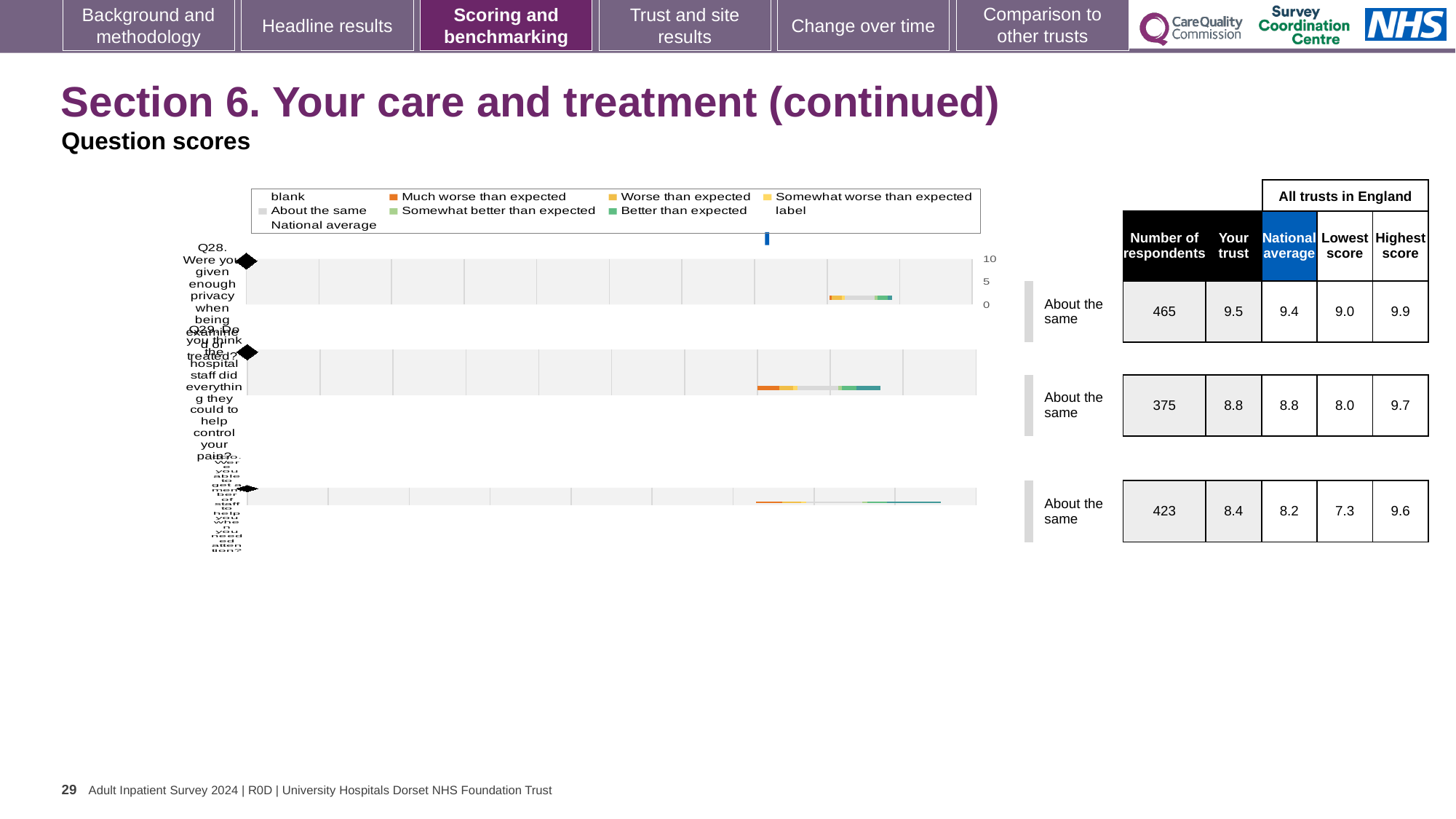
How many respondents are listed for the third question (Q30)? 423 What is the lowest score among all trusts in England for the third question (Q30)? 7.3 What is the highest score among all trusts in England for Q28? 9.9 For Q29 (Do you think the hospital staff did everything they could to help control your pain?), what is the national average score? 8.8 What is the difference between the highest and lowest scores among all trusts in England for the third question (Q30)? 2.3 Which question has the highest 'Your trust' score on this slide? Q28 For Q28 (Were you given enough privacy when being examined or treated?), what is the 'Your trust' score shown? 9.5 What benchmark category is shown for Q29? About the same How many questions are plotted on this slide? 3 What is the difference between the 'Your trust' score and the national average for Q28? 0.1 What kind of chart is used to show the question scores? Bar chart For the third question (Q30), which is larger: the 'Your trust' score or the national average? Your trust